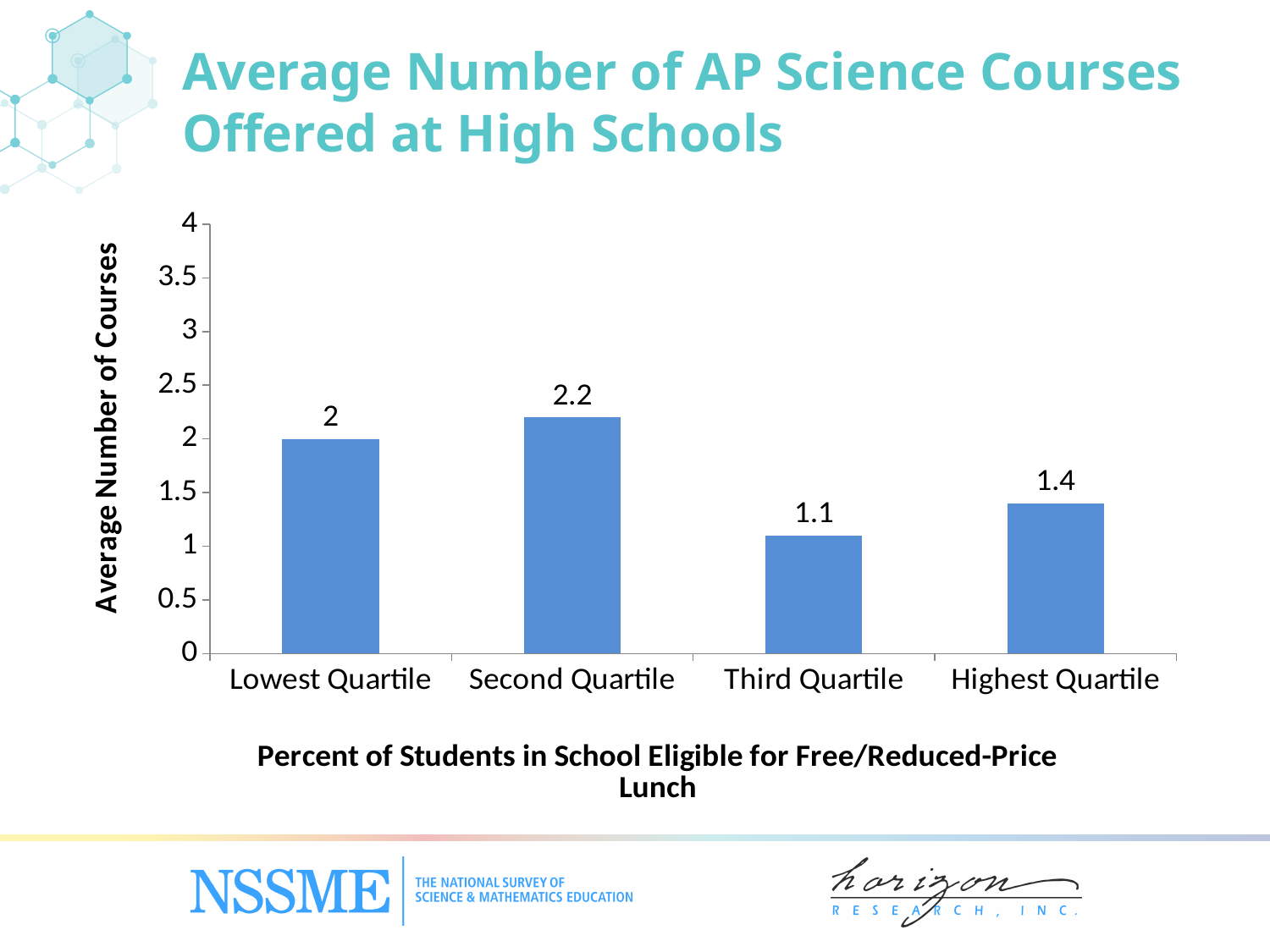
What is the average number of AP science courses offered at high schools in the Highest Quartile? 1.4 Which quartile has the lowest average number of AP science courses? Third Quartile How many quartile categories are shown on the x axis? 4 What is the average number of AP science courses offered at high schools in the Second Quartile? 2.2 What is the label of the x axis? Percent of Students in School Eligible for Free/Reduced-Price Lunch What is the average number of AP science courses offered at high schools in the Lowest Quartile? 2 What is the difference between the average number of AP science courses in the Second Quartile and the Third Quartile? 1.1 What is the average number of AP science courses offered at high schools in the Third Quartile? 1.1 What kind of chart is shown on the slide? Bar chart Is the value for the Highest Quartile greater or less than 1.5? less Which quartile has the highest average number of AP science courses? Second Quartile Which has a higher average number of AP science courses, the Lowest Quartile or the Highest Quartile? Lowest Quartile